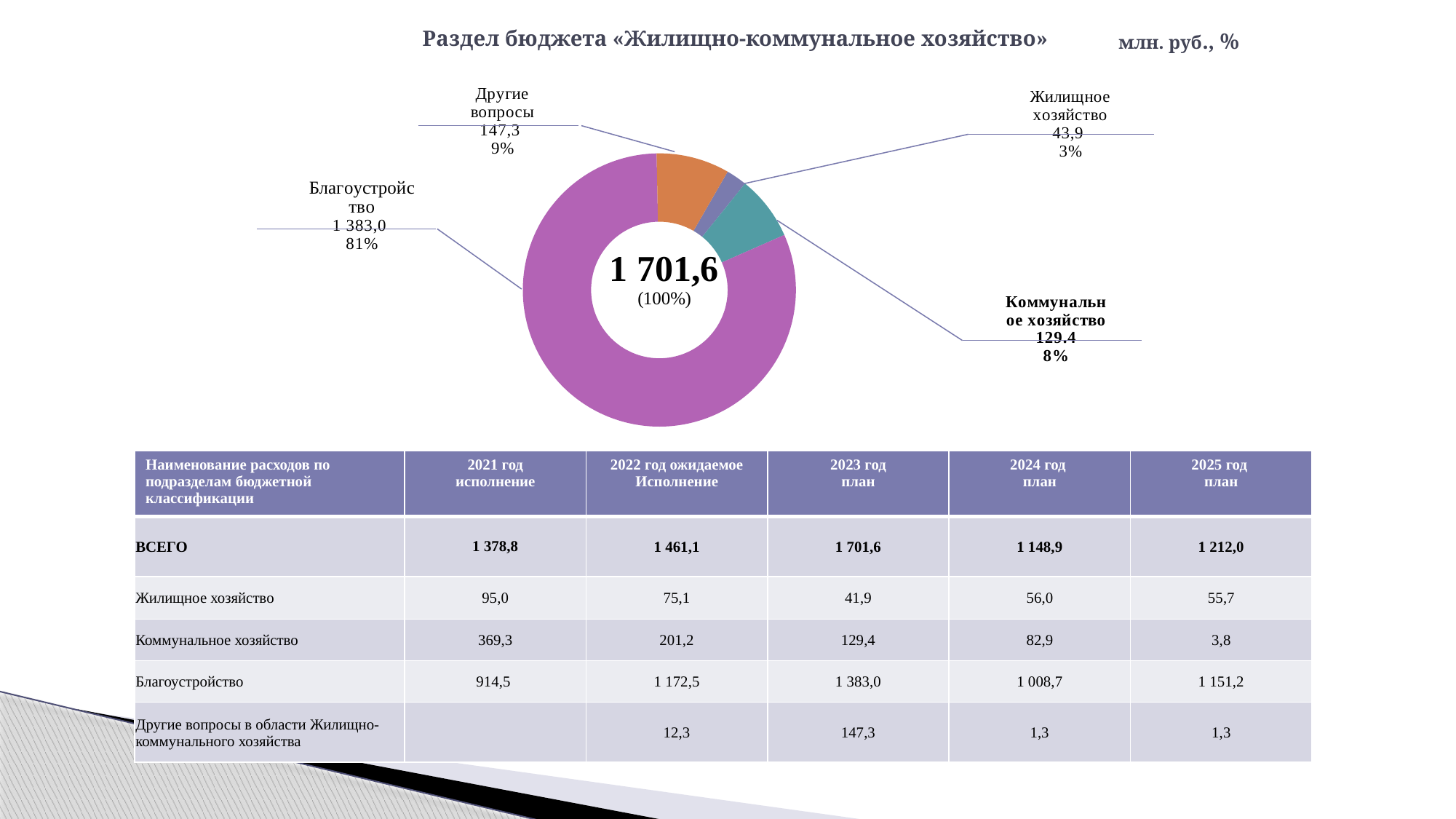
What total value is shown in the centre of the donut chart? 1 701,6 What kind of chart is shown on the slide? Donut (pie) chart What percentage share does Жилищное хозяйство have in the donut chart? 3% What is the value shown for Другие вопросы in the donut chart? 147,3 Which category has the smallest slice in the donut chart? Жилищное хозяйство Which category has the largest slice in the donut chart? Благоустройство Which is larger in the donut chart: Другие вопросы or Коммунальное хозяйство? Другие вопросы What is the value shown for Благоустройство in the donut chart? 1 383,0 What is the title of the chart on the slide? Раздел бюджета «Жилищно-коммунальное хозяйство» What percentage share does Благоустройство have in the donut chart? 81% How many categories are shown in the donut chart? 4 What value is shown for Коммунальное хозяйство in the donut chart? 129.4